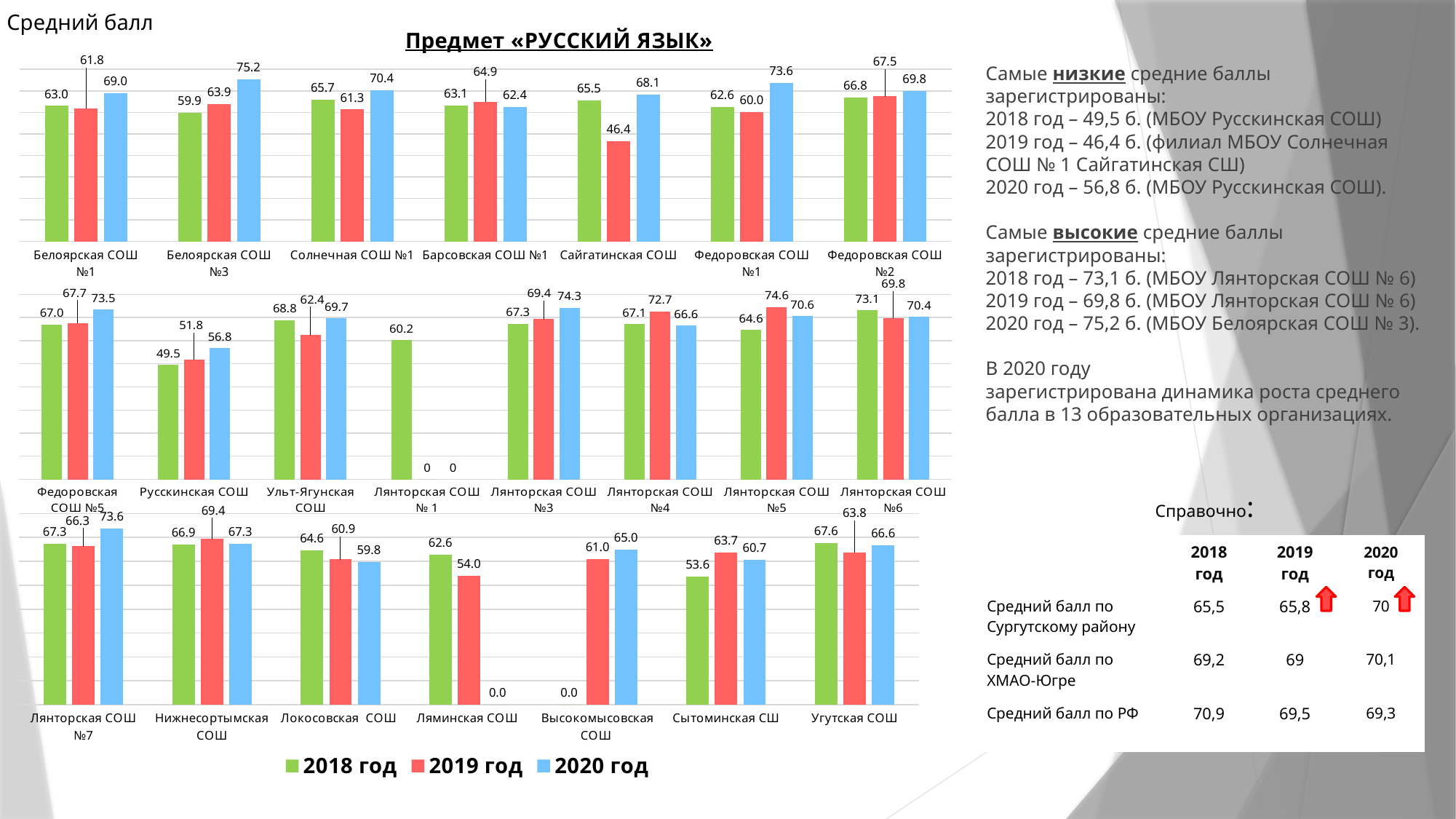
In the top chart, which school has the highest 2020 год value? Белоярская СОШ №3 In the middle chart, what is the 2018 год value for Русскинская СОШ? 49.5 In the bottom chart, which is larger for Локосовская СОШ: the 2018 год value or the 2020 год value? 2018 год What kind of chart is used on the slide? bar chart How many series does the legend list? 3 In the bottom chart, what is the 2019 год value for Сытоминская СШ? 63.7 In the top chart, what is the difference between the 2020 год and 2018 год values for Федоровская СОШ №1? 11.0 In the top chart, what is the 2020 год value for Белоярская СОШ №3? 75.2 How many schools are shown in the bottom chart? 7 In the top chart, what is the 2019 год value for Сайгатинская СОШ? 46.4 In the middle chart, which school has the lowest 2018 год value? Русскинская СОШ In the middle chart, do the values for Русскинская СОШ rise or fall from 2018 год to 2020 год? rise